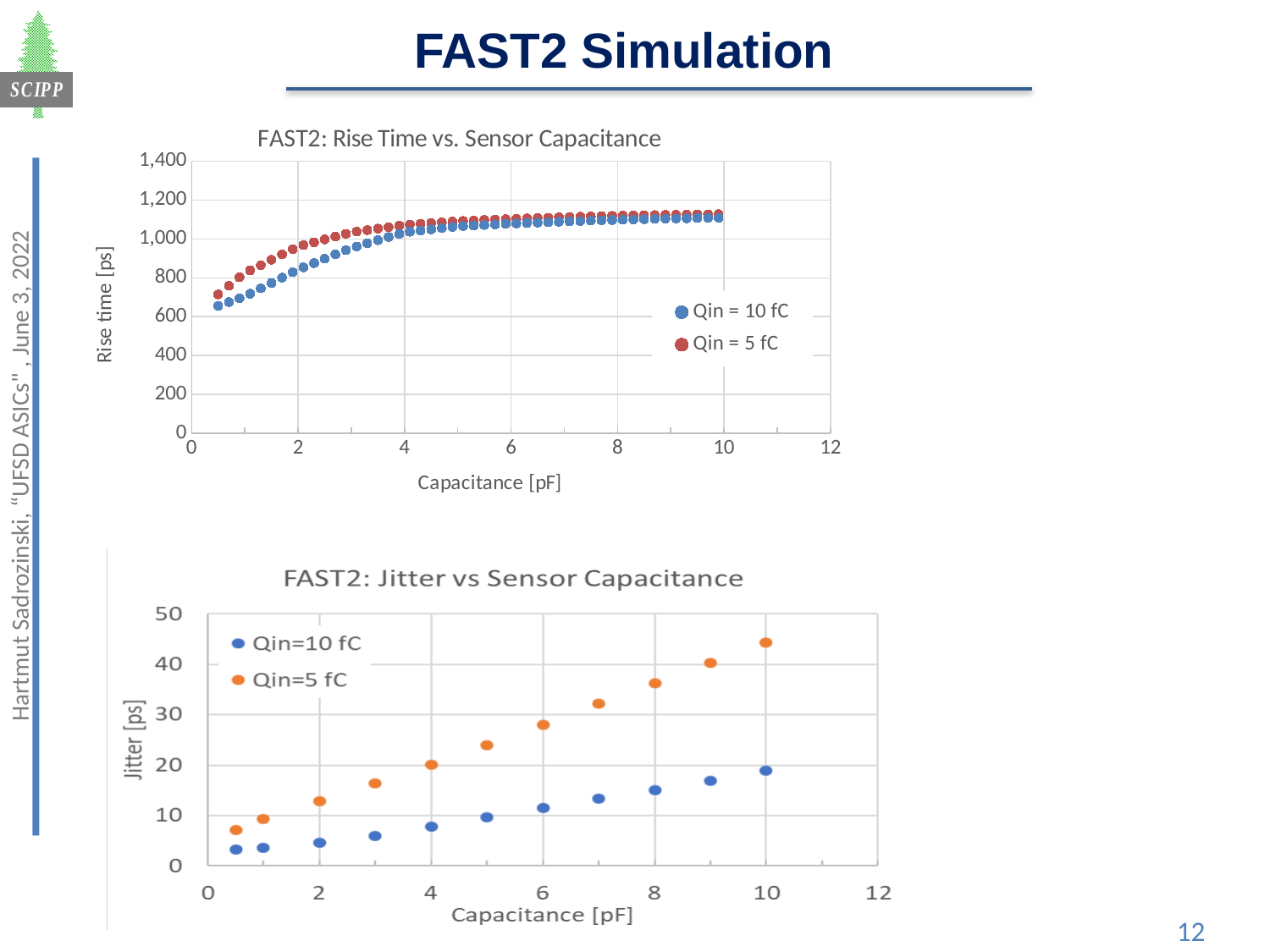
What is the title of the bottom chart? FAST2: Jitter vs Sensor Capacitance In the top chart (Rise Time vs. Sensor Capacitance), does the rise time for Qin = 10 fC rise or fall as capacitance increases? rise In the bottom chart (Jitter vs Sensor Capacitance), is the jitter for Qin=10 fC at 2 pF greater or less than 10? less In the top chart (Rise Time vs. Sensor Capacitance), at 2 pF which series has the higher rise time, Qin = 10 fC or Qin = 5 fC? Qin = 5 fC How many series does the legend of the top chart (Rise Time vs. Sensor Capacitance) list? 2 In the top chart (Rise Time vs. Sensor Capacitance), what is the label of the y axis? Rise time [ps] How many series does the legend of the bottom chart (Jitter vs Sensor Capacitance) list? 2 What type of chart is the top chart titled 'FAST2: Rise Time vs. Sensor Capacitance'? scatter chart In the top chart (Rise Time vs. Sensor Capacitance), is the rise time for Qin = 5 fC at 10 pF greater or less than 1,000? greater In the top chart (Rise Time vs. Sensor Capacitance), is the rise time for Qin = 10 fC at 1 pF greater or less than 800? less In the bottom chart (Jitter vs Sensor Capacitance), at 10 pF which series has the higher jitter, Qin=10 fC or Qin=5 fC? Qin=5 fC